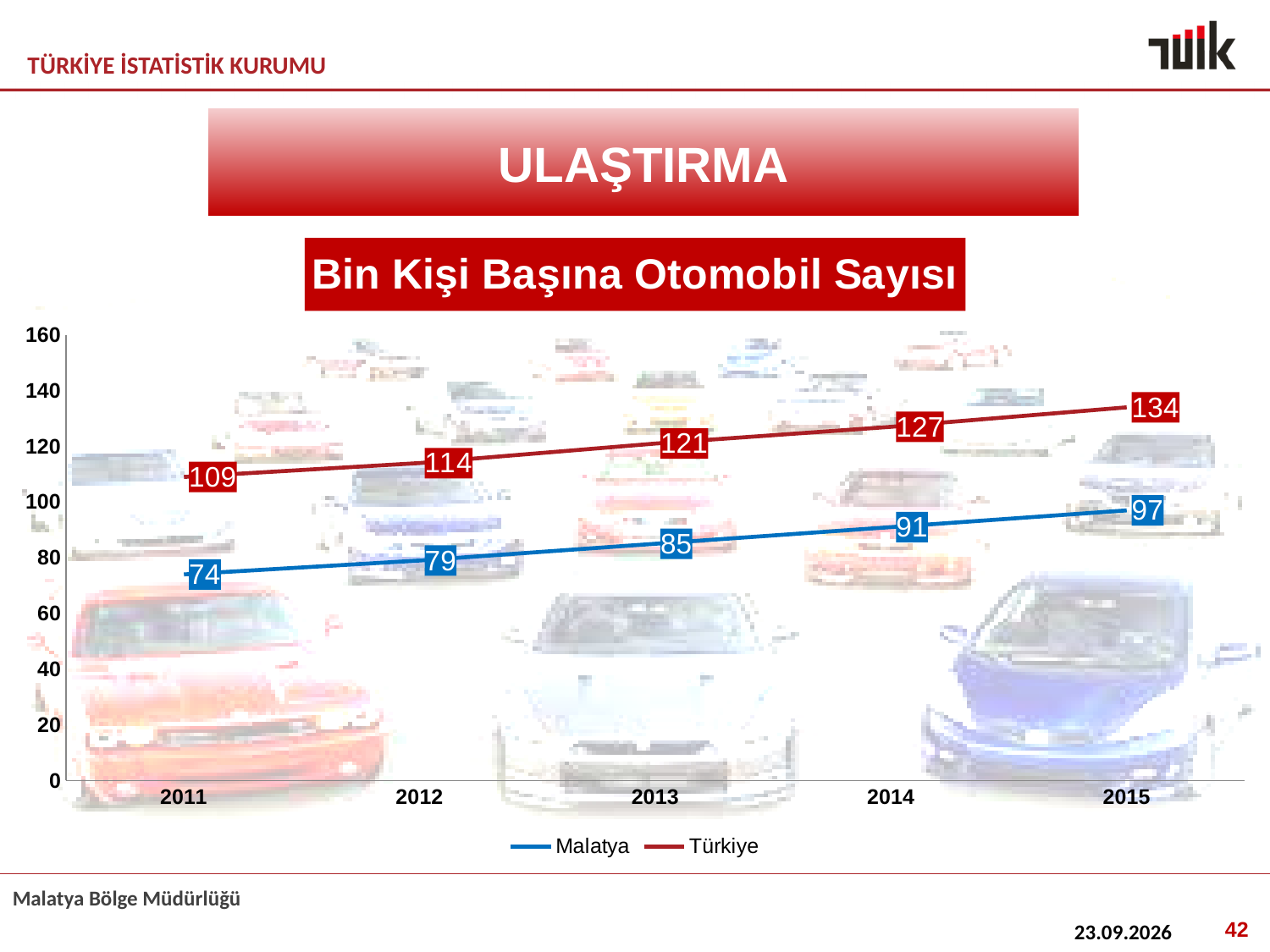
In which year is the Malatya value highest? 2015 What is the value for Türkiye in 2012? 114 What is the value for Malatya in 2011? 74 In which year is the Türkiye value lowest? 2011 What kind of chart is shown? line chart What is the value for Türkiye in 2015? 134 What is the value for Malatya in 2013? 85 How many years are shown on the x axis? 5 How many series does the legend list? 2 Do the Malatya values rise or fall from 2011 to 2015? rise Which is larger in 2013, the Malatya value or the Türkiye value? Türkiye What is the difference between the Türkiye and Malatya values in 2014? 36